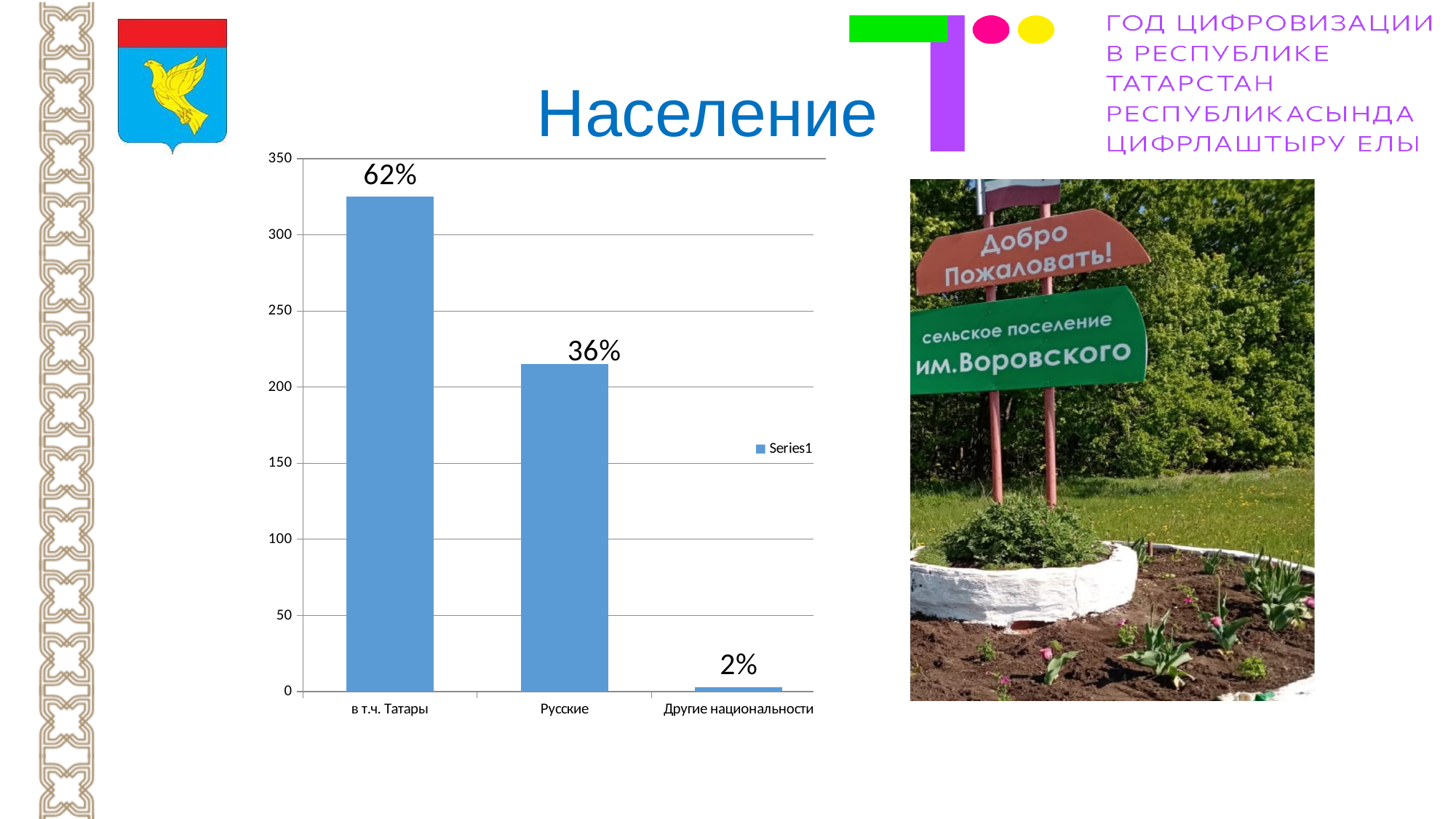
Is the bar for в т.ч. Татары greater or less than 300 on the y axis? greater Which category has the lowest bar in the chart? Другие национальности What is the difference between the percentage labels for в т.ч. Татары and Русские? 26% What type of chart is shown on the slide? bar chart Is the bar for Русские greater or less than 200 on the y axis? greater How many categories are shown on the x axis of the chart? 3 What data label is printed above the bar for Русские? 36% What data label is printed above the bar for в т.ч. Татары? 62% What is the title of the slide containing the chart? Население What data label is printed above the bar for Другие национальности? 2% Which category has the highest bar in the chart? в т.ч. Татары How many series does the chart legend list? 1